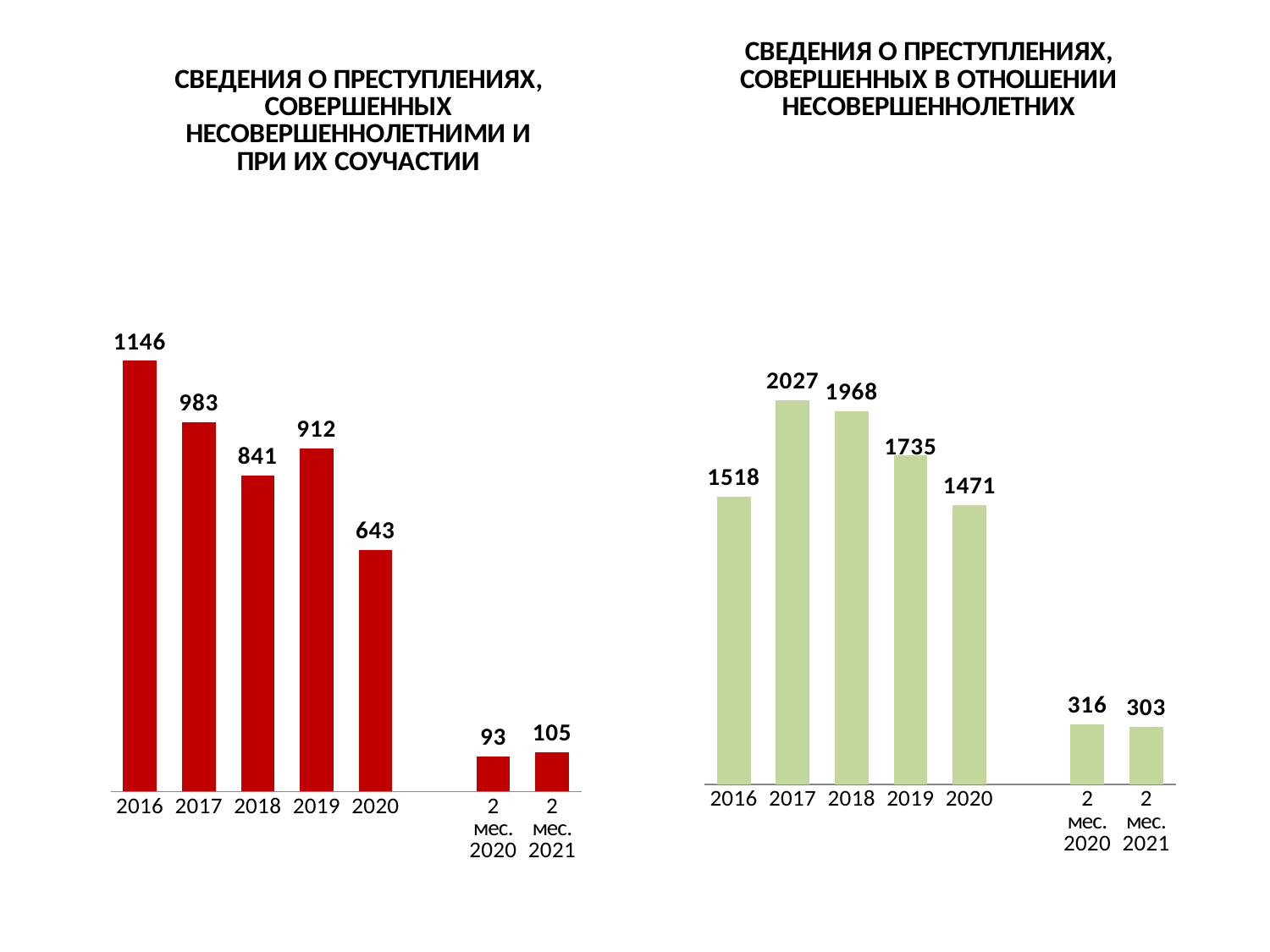
In the left chart, which year from 2016 to 2020 has the lowest value? 2020 What colour are the bars in the right chart? Light green In the left chart, what is the difference between the values for 2016 and 2020? 503 In the left chart, which is larger: the value for 2 мес. 2020 or 2 мес. 2021? 2 мес. 2021 In the right chart, which is larger: the value for 2016 or 2020? 2016 In the right chart, what is the difference between the values for 2 мес. 2020 and 2 мес. 2021? 13 In the left chart (crimes committed by minors and with their participation), what is the value for 2016? 1146 In the left chart, do the values rise or fall from 2016 to 2020? Fall What kind of chart is the right chart? Bar chart How many bars are plotted in the left chart? 7 In the right chart, which category has the highest value? 2017 In the right chart (crimes committed against minors), what is the value for 2019? 1735